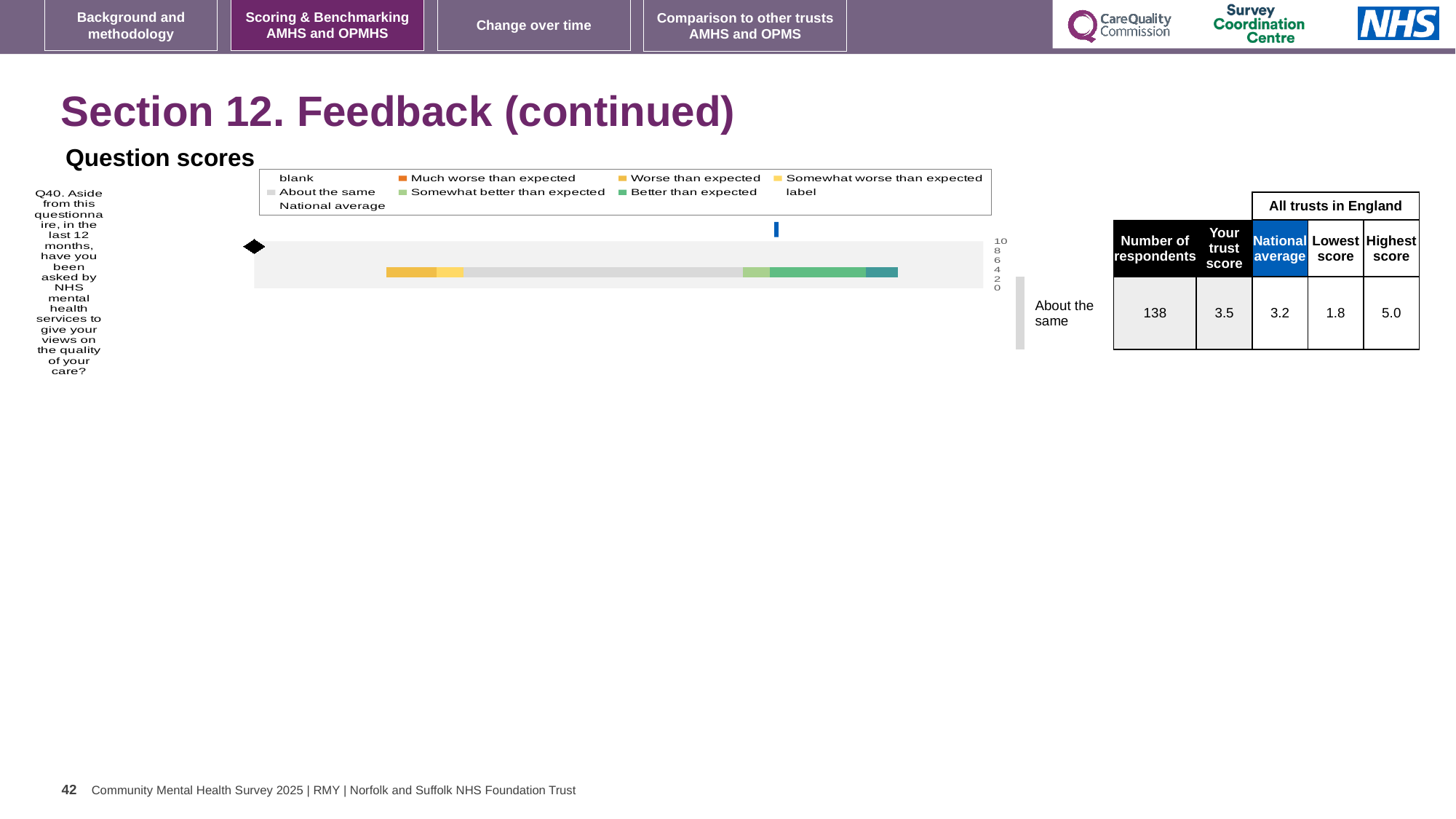
What is the national average score for Q40? 3.2 For Q40, what is the difference between the trust score and the national average? 0.3 What is the trust score for Q40? 3.5 For Q40, what is the difference between the highest score and the lowest score among all trusts in England? 3.2 Which benchmark category is shown for Q40 next to the chart? About the same What is the number of respondents for Q40? 138 What is the highest score among all trusts in England for Q40? 5.0 What kind of chart is used to show the Q40 question score? bar chart Which question number is plotted in the Question scores chart? Q40 How many questions are plotted in the Question scores chart? 1 What is the lowest score among all trusts in England for Q40? 1.8 For Q40, which is larger: the trust score or the national average? the trust score